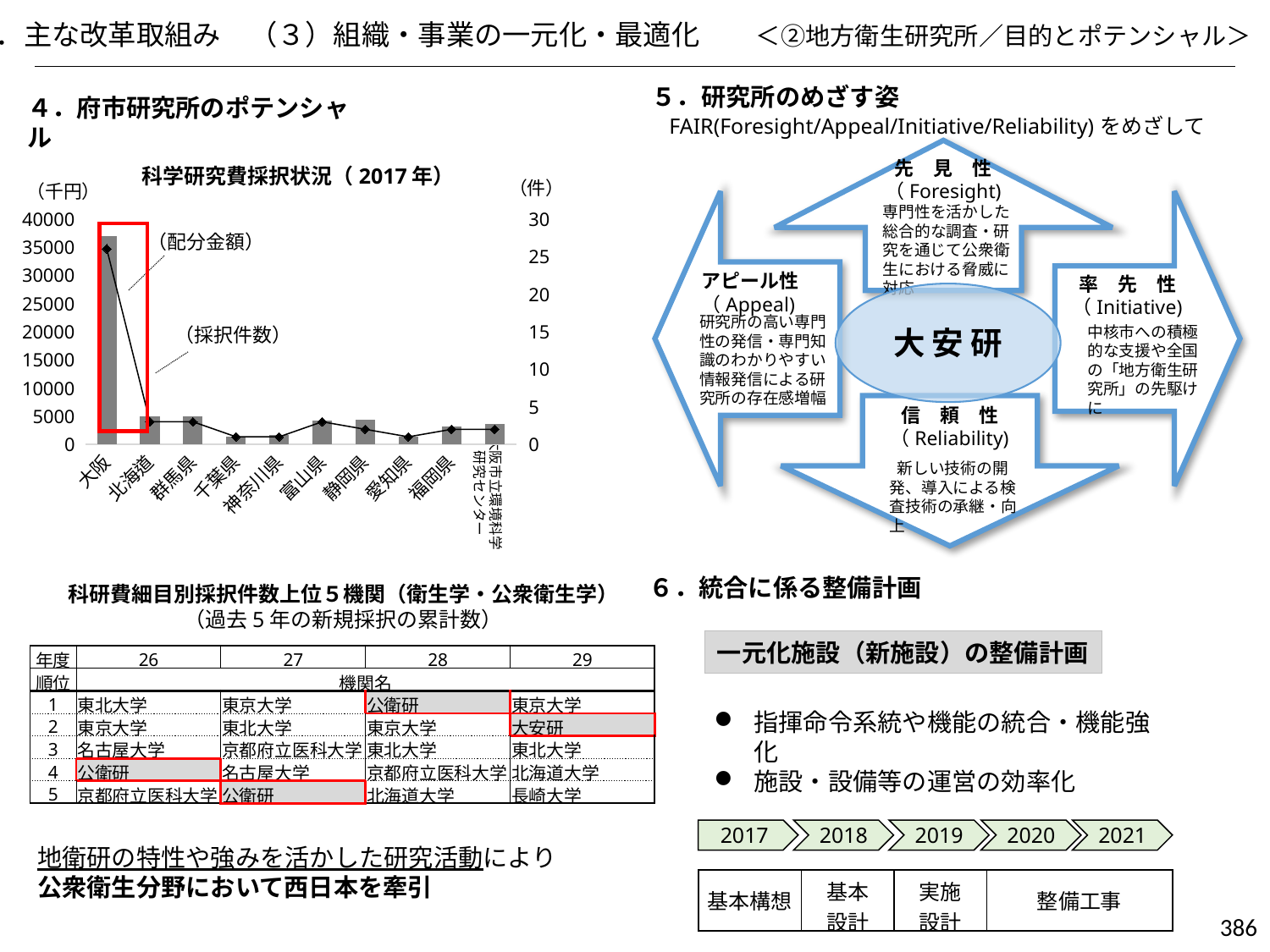
What unit is shown on the right axis of the 科学研究費採択状況（2017年） chart? 件 In the 科学研究費採択状況（2017年） chart, is the 配分金額 value for 北海道 greater or less than 10000? less What kind of chart is 科学研究費採択状況（2017年）? A bar chart with a line In the 科学研究費採択状況（2017年） chart, which category has the highest 配分金額 bar? 大阪 In the 科学研究費採択状況（2017年） chart, which has the larger 配分金額 bar, 富山県 or 千葉県? 富山県 How many data series are plotted in the 科学研究費採択状況（2017年） chart? 2 In the 科学研究費採択状況（2017年） chart, is the 採択件数 value for 千葉県 greater or less than 5? less In the 科学研究費採択状況（2017年） chart, is the 採択件数 value for 大阪 greater or less than 20? greater In the 科学研究費採択状況（2017年） chart, do the 配分金額 values rise or fall from 大阪 to 北海道? fall How many categories are shown on the x axis of the 科学研究費採択状況（2017年） chart? 10 What unit is shown on the left axis of the 科学研究費採択状況（2017年） chart? 千円